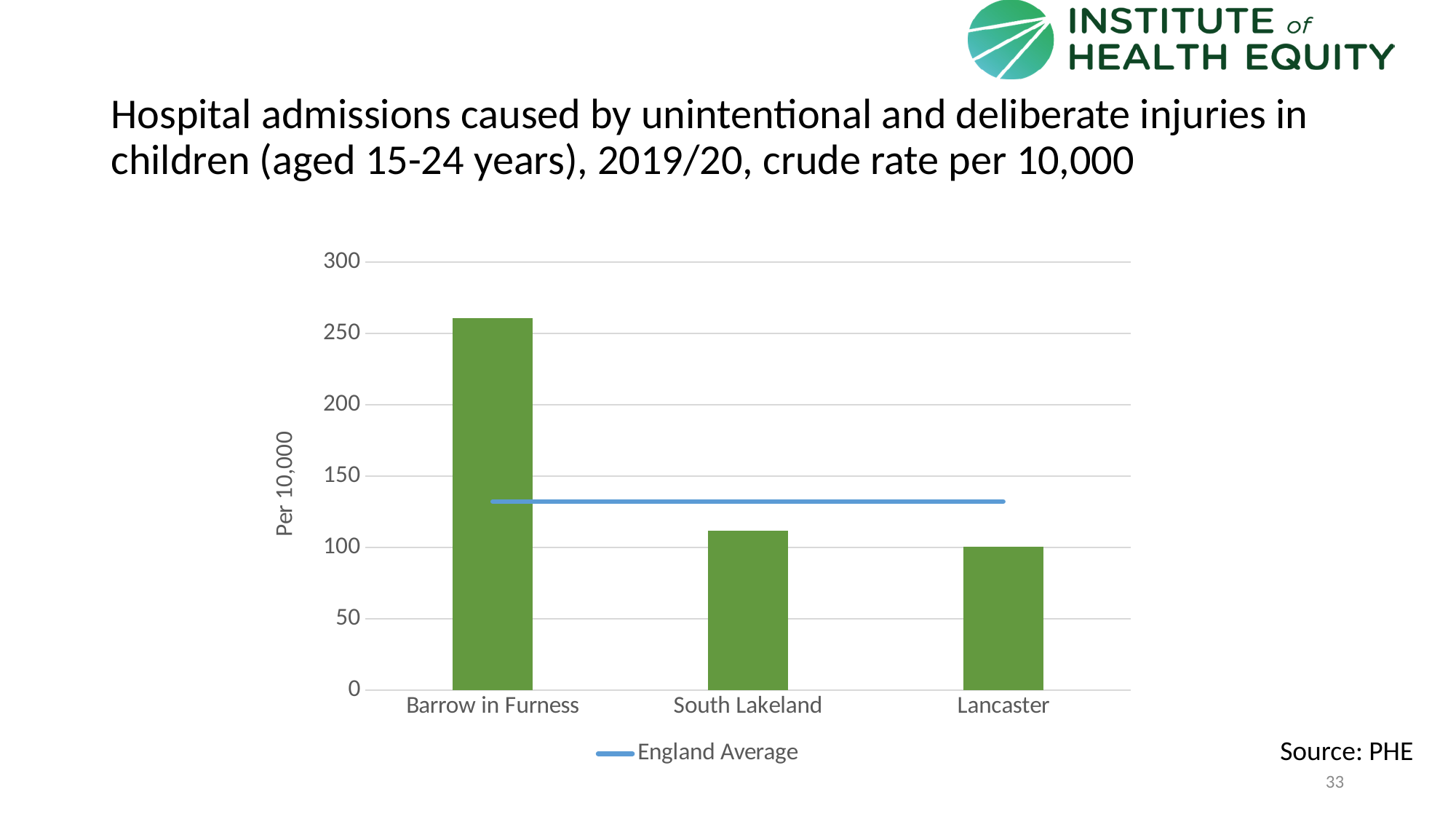
Which area has the highest hospital admission rate? Barrow in Furness How many series does the legend list? 1 Is the value for South Lakeland greater or less than 150? less Is the England Average line greater or less than 150? less Do the bar values rise or fall from left to right along the x axis? fall What entry does the legend show? England Average Which area has the lowest hospital admission rate? Lancaster What kind of chart is shown on the slide? bar and line chart Is the value for Barrow in Furness greater or less than 250? greater How many areas (categories) are plotted on the x axis? 3 Which has the larger value, South Lakeland or Lancaster? South Lakeland What is the label on the y axis? Per 10,000